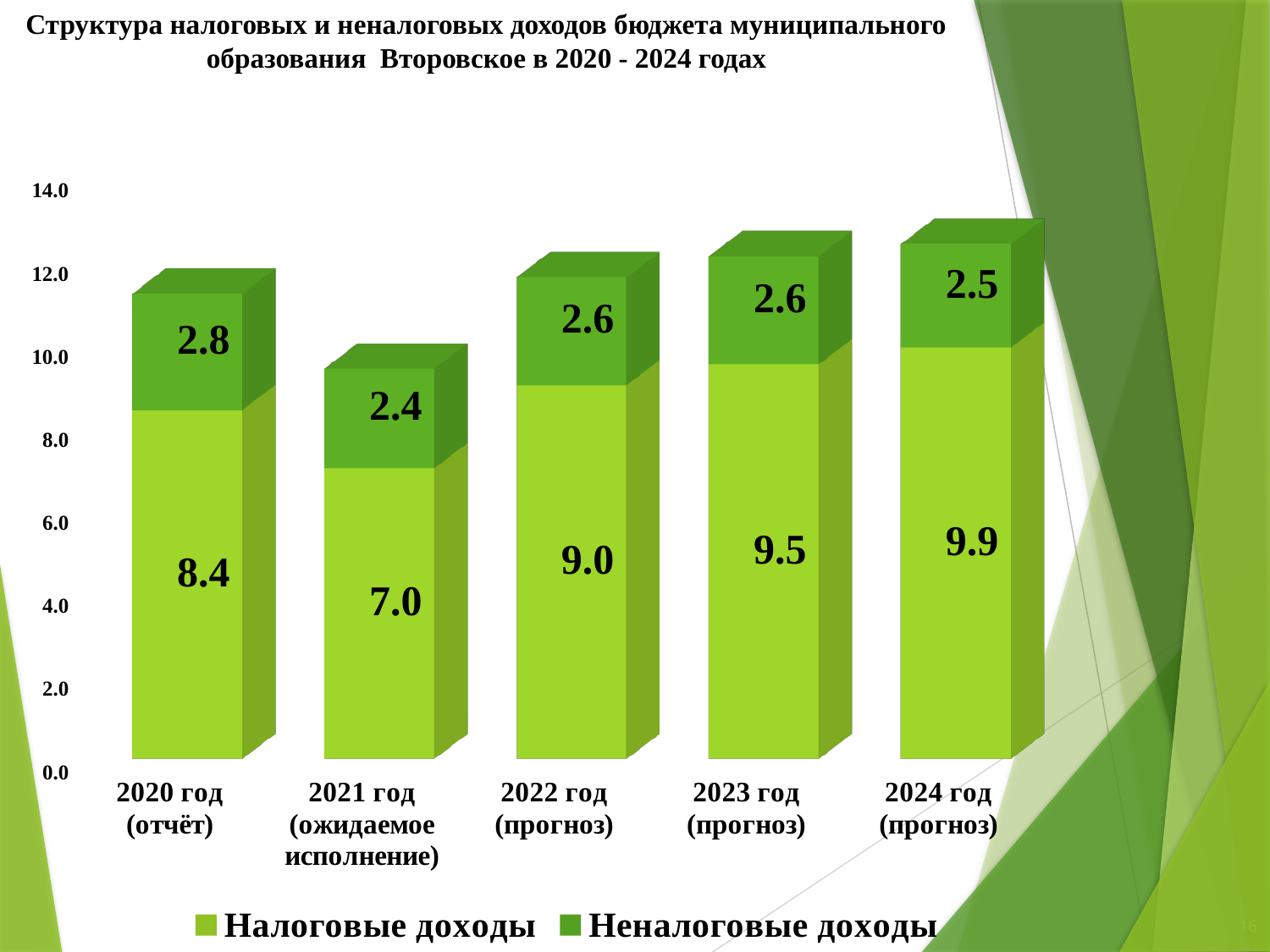
What is the total of the stacked bar for 2021 год (ожидаемое исполнение)? 9.4 What type of chart is shown on the slide? Stacked bar chart How many years (categories) are shown on the x axis? 5 Which is larger: Налоговые доходы in 2020 год (отчёт) or in 2021 год (ожидаемое исполнение)? 2020 год (отчёт) What is the value of Налоговые доходы for 2024 год (прогноз)? 9.9 What is the value of Неналоговые доходы for 2020 год (отчёт)? 2.8 What is the total of the stacked bar for 2024 год (прогноз)? 12.4 What is the value of Налоговые доходы for 2021 год (ожидаемое исполнение)? 7.0 What is the difference between Налоговые доходы in 2023 год (прогноз) and 2022 год (прогноз)? 0.5 How many series does the legend list? 2 Which year has the lowest value of Неналоговые доходы? 2021 год (ожидаемое исполнение) Which year has the highest value of Налоговые доходы? 2024 год (прогноз)